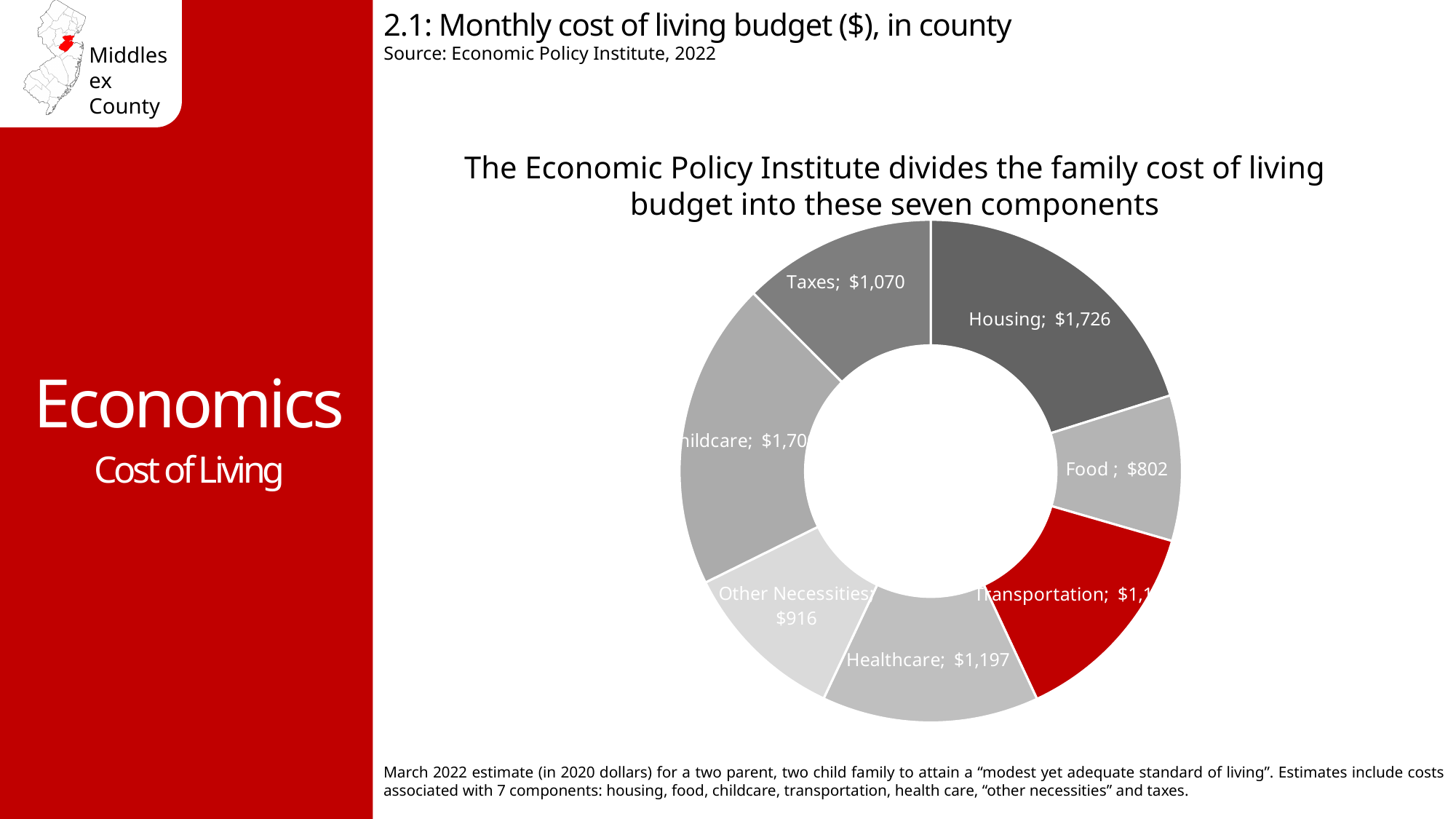
What is the difference between the housing cost and the food cost? $924 What type of chart is shown on the slide? Doughnut (pie) chart Which component has the lowest monthly cost in the chart? Food Which component's slice is coloured red in the chart? Transportation What is the monthly healthcare cost shown in the chart? $1,197 What is the monthly housing cost shown in the chart? $1,726 What is the monthly cost for other necessities shown in the chart? $916 What is the monthly food cost shown in the chart? $802 What is the difference between the healthcare cost and the taxes cost? $127 What is the monthly cost for taxes shown in the chart? $1,070 How many components does the chart divide the cost of living budget into? 7 Which is larger, the healthcare cost or the taxes cost? Healthcare